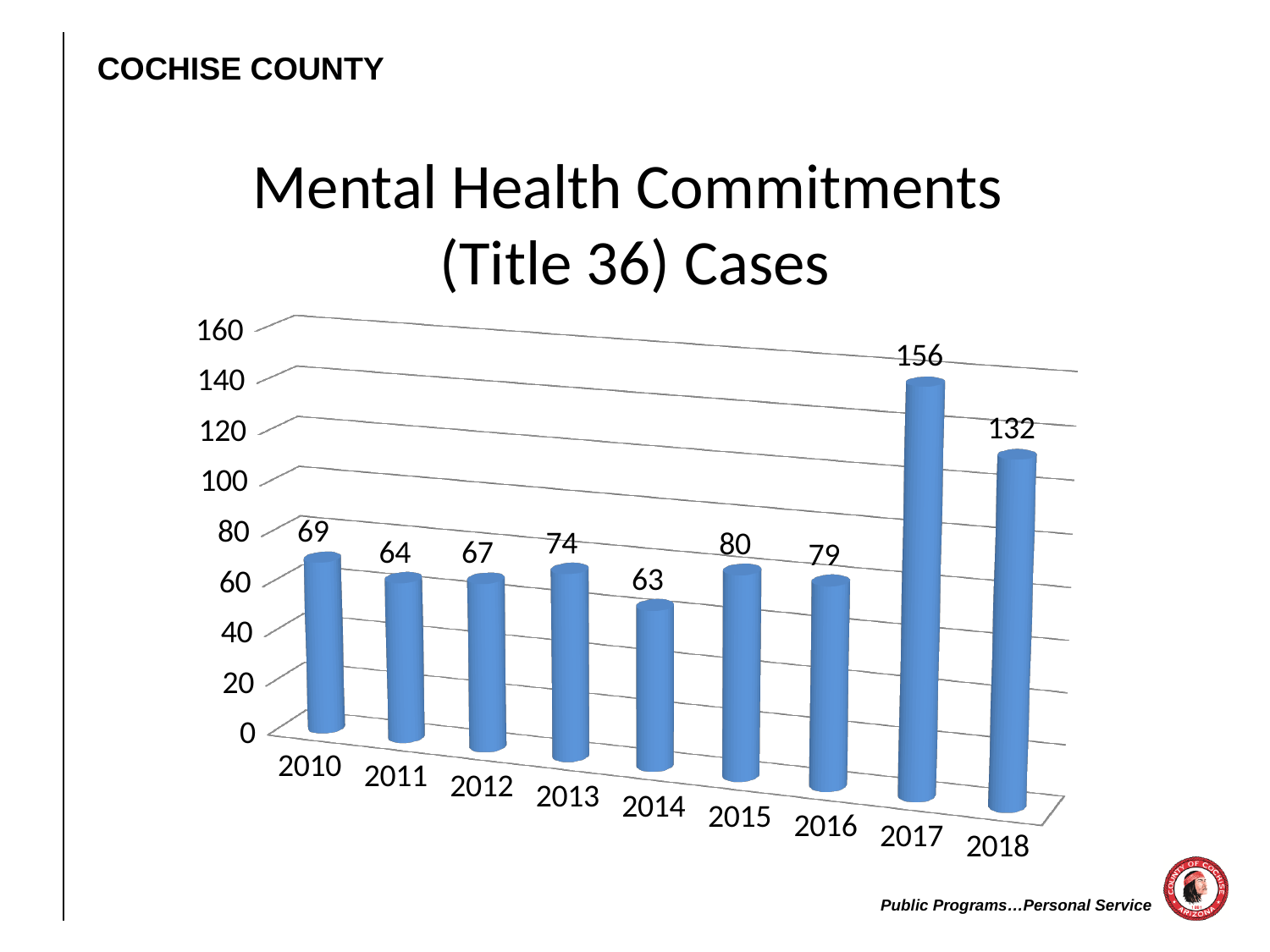
What is the number of Mental Health Commitments (Title 36) cases in 2010? 69 What is the difference in Mental Health Commitments (Title 36) cases between 2015 and 2014? 17 What is the difference in Mental Health Commitments (Title 36) cases between 2017 and 2018? 24 What kind of chart is used to show Mental Health Commitments (Title 36) Cases? Bar chart Which year had more Mental Health Commitments (Title 36) cases, 2013 or 2016? 2016 How many years are shown in the Mental Health Commitments (Title 36) Cases chart? 9 Which year has the lowest number of Mental Health Commitments (Title 36) cases? 2014 What is the title of the chart on the slide? Mental Health Commitments (Title 36) Cases Is the number of Mental Health Commitments (Title 36) cases in 2018 greater or less than 120? greater What is the number of Mental Health Commitments (Title 36) cases in 2017? 156 Which year has the highest number of Mental Health Commitments (Title 36) cases? 2017 What is the number of Mental Health Commitments (Title 36) cases in 2014? 63